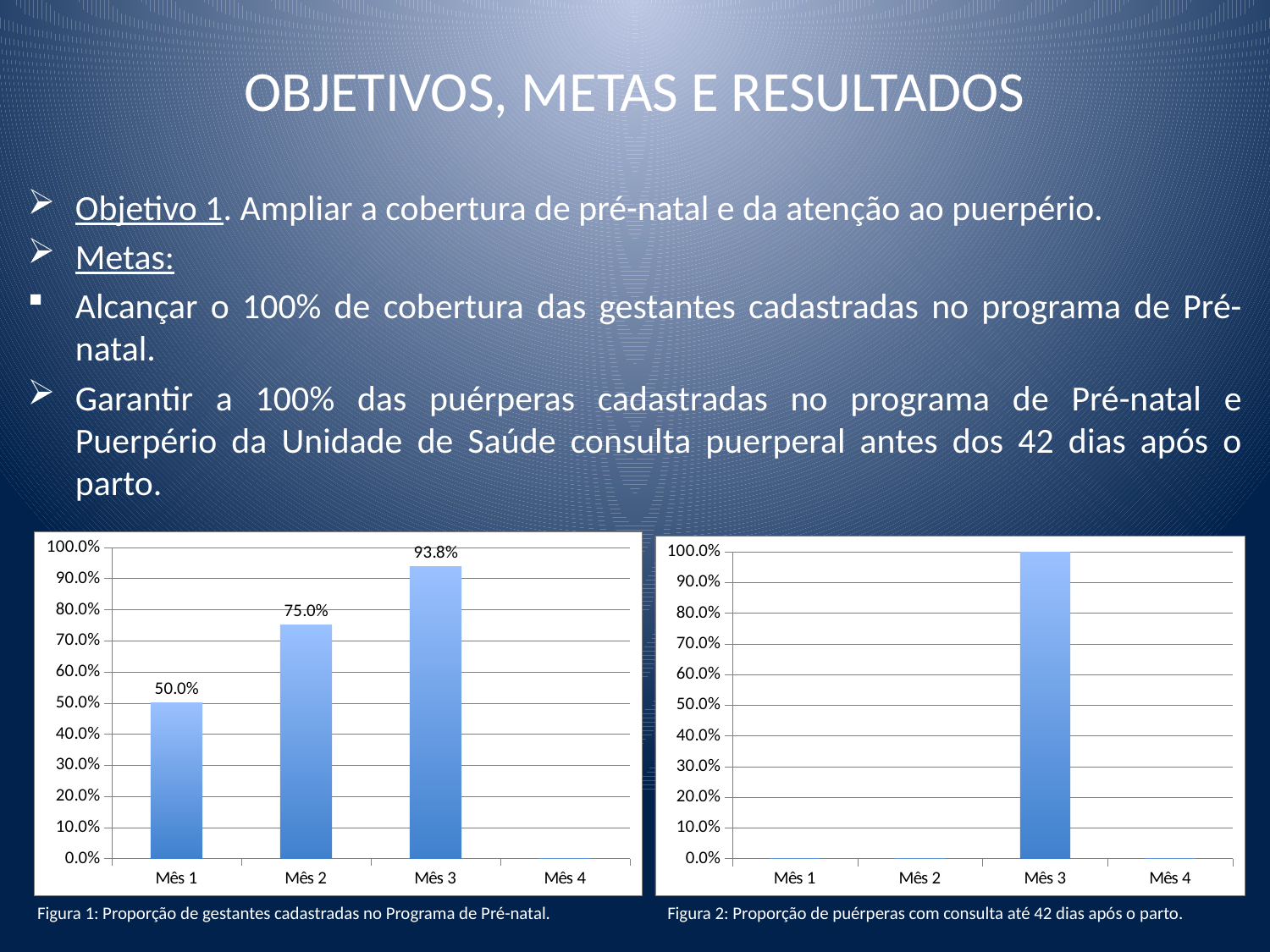
In the left chart (Figura 1), which is larger, the value for Mês 1 or the value for Mês 2? Mês 2 In the left chart (Figura 1), do the values rise or fall from Mês 1 to Mês 3? rise In the left chart (Figura 1), how many month categories are shown on the x axis? 4 What is the caption of the left chart? Figura 1: Proporção de gestantes cadastradas no Programa de Pré-natal. In the left chart (Figura 1), what is the value for Mês 2? 75.0% In the right chart (Figura 2), which month has the highest value? Mês 3 In the left chart (Figura 1), what is the difference between the values for Mês 3 and Mês 1? 43.8% What kind of chart is the right chart (Figura 2)? bar chart In the right chart (Figura 2), is the value for Mês 3 greater or less than 90.0%? greater In the left chart (Figura 1), what is the value for Mês 1? 50.0% In the left chart (Figura 1), which month has the highest value? Mês 3 In the left chart (Figura 1), what is the value for Mês 3? 93.8%